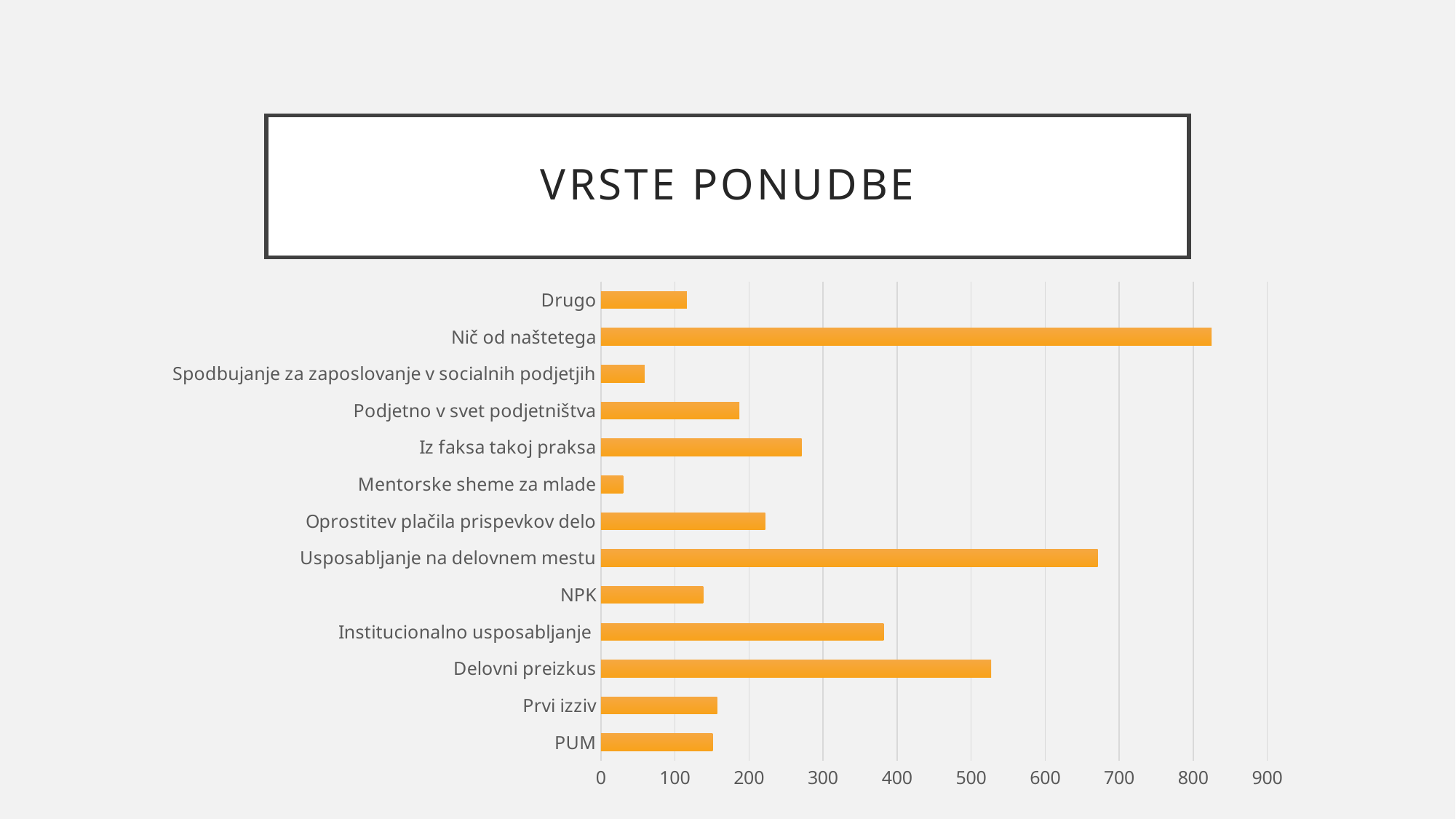
Which category has the highest value? Nič od naštetega Which is larger, the value for Usposabljanje na delovnem mestu or the value for Nič od naštetega? Nič od naštetega What colour are the bars in the chart? orange Which category has the lowest value? Mentorske sheme za mlade What is the title of the slide? VRSTE PONUDBE How many categories are plotted in the chart? 13 Which is larger, the value for Delovni preizkus or the value for Institucionalno usposabljanje? Delovni preizkus Is the value for Iz faksa takoj praksa greater or less than 300? less Is the value for Nič od naštetega greater or less than 800? greater What kind of chart is shown on the slide? bar chart Is the value for Delovni preizkus greater or less than 500? greater